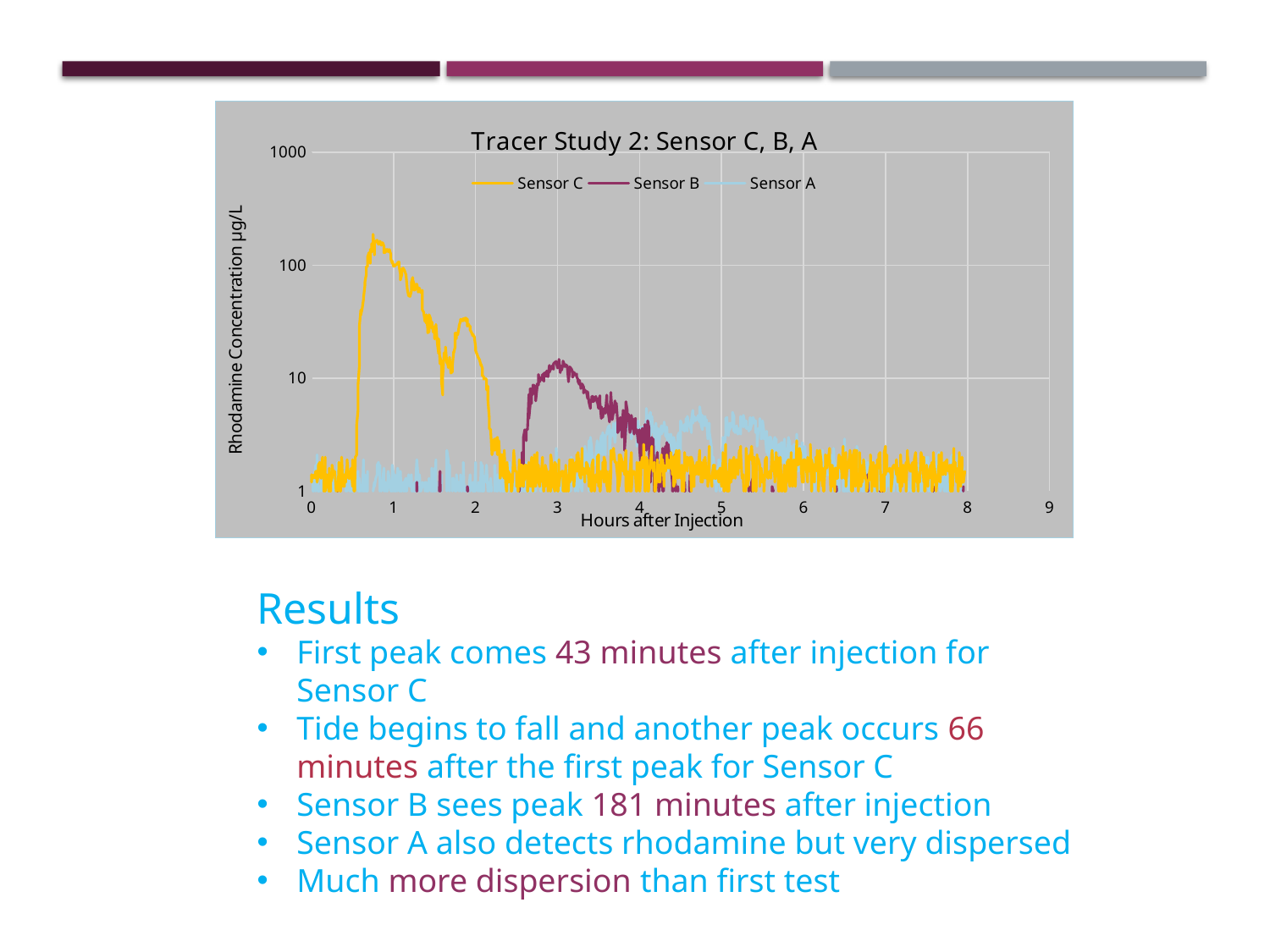
Is the peak value for Sensor B greater or less than 100? less How many series does the chart legend list? 3 Which sensor's concentration peaks first along the x axis? Sensor C Which has the higher peak concentration, Sensor B or Sensor A? Sensor B What is the highest value shown on the y axis of the chart? 1000 Which sensor has the lowest peak concentration in the chart? Sensor A What kind of chart is shown on the slide? Line chart Which sensor reaches the highest rhodamine concentration in the chart? Sensor C Is the peak value for Sensor C greater or less than 100? greater What is the title of the chart? Tracer Study 2: Sensor C, B, A Is the peak value for Sensor A greater or less than 10? less What is the label of the y axis of the chart? Rhodamine Concentration µg/L